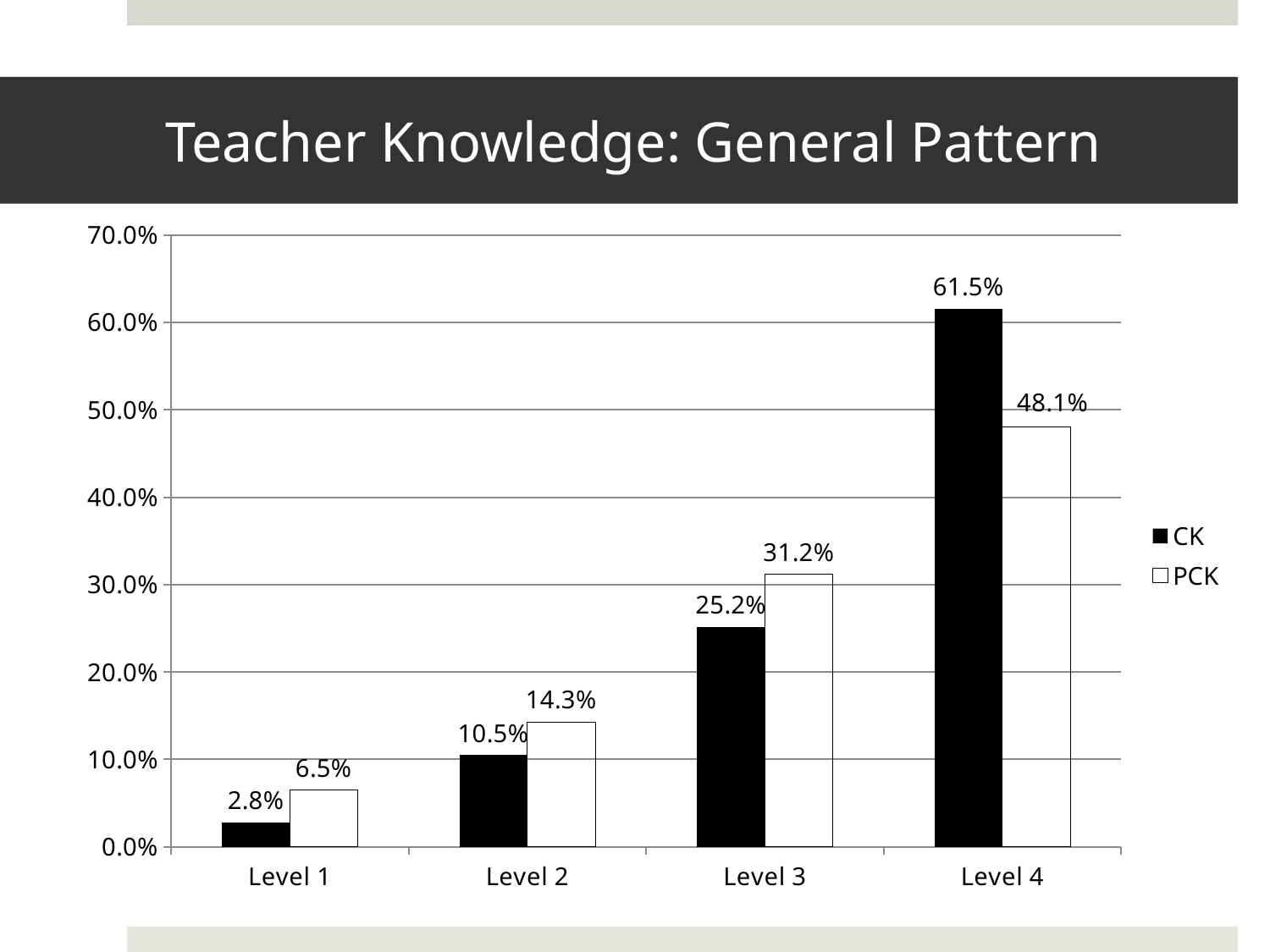
How many levels are shown on the x axis? 4 How many series does the legend list? 2 What is the PCK value for Level 2? 14.3% Is the PCK value for Level 3 greater or less than 30.0%? greater What kind of chart is shown on the slide? Bar chart What is the CK value for Level 1? 2.8% What is the difference between the CK and PCK values for Level 4? 13.4% Which level has the highest PCK value? Level 4 Which level has the lowest CK value? Level 1 Which is larger for Level 3, CK or PCK? PCK Do the CK values rise or fall from Level 1 to Level 4? Rise What is the CK value for Level 4? 61.5%